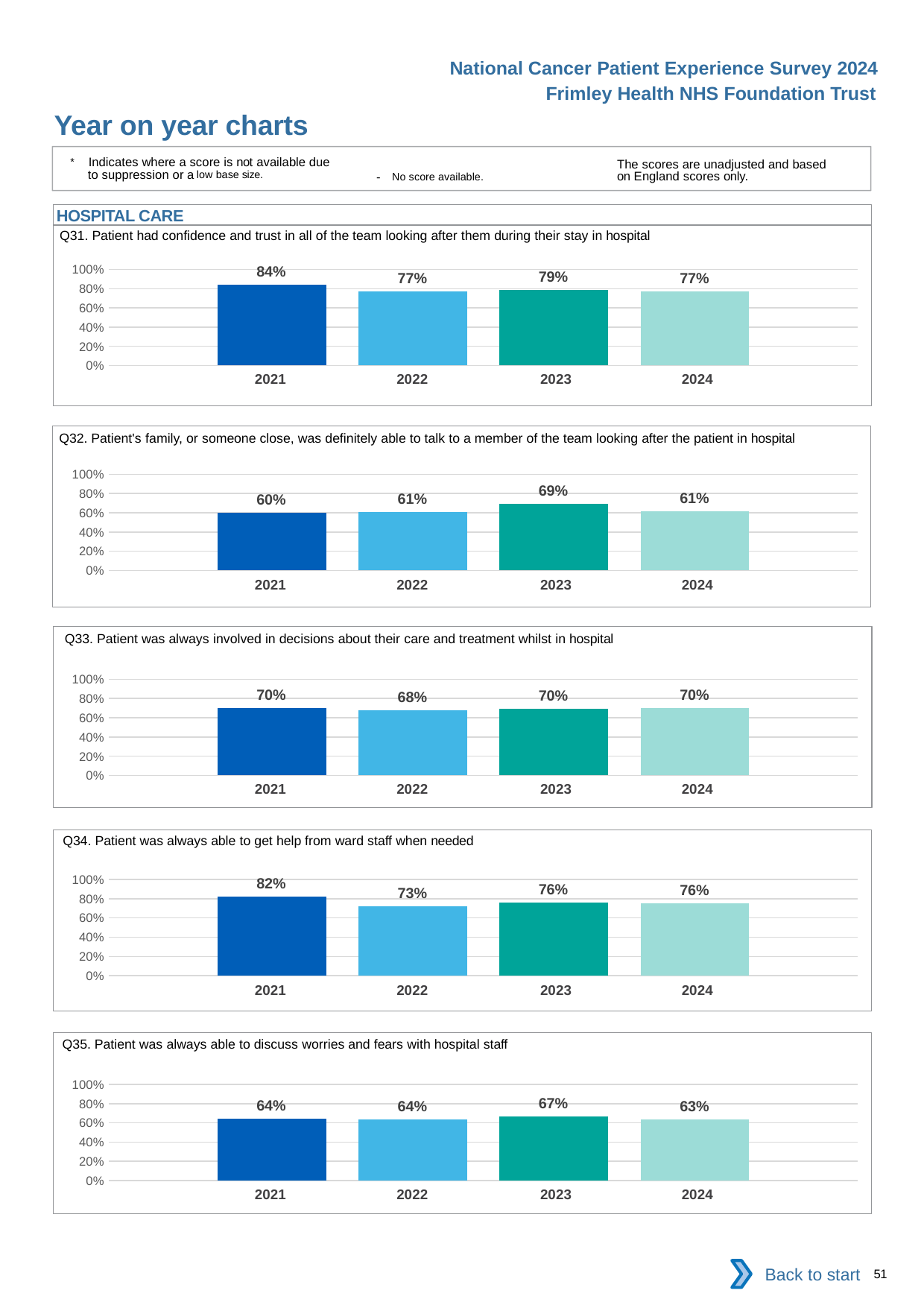
How many charts are shown on the slide? 5 In the Q32 chart, which year has the highest value? 2023 In the Q31 chart, what is the difference between the 2021 and 2022 values? 7 percentage points In the Q34 chart, is the value for 2021 greater or less than 80%? greater In the Q35 chart, which is larger, the value for 2023 or the value for 2024? 2023 In the Q32 chart, what is the difference between the 2023 and 2024 values? 8 percentage points In the Q33 chart, what is the value for 2022? 68% In the Q31 chart, what is the value for 2021? 84% In the Q35 chart, what is the value for 2024? 63% What kind of chart is the Q32 chart? Bar chart How many years are shown in the Q34 chart? 4 In the Q34 chart, which year has the lowest value? 2022